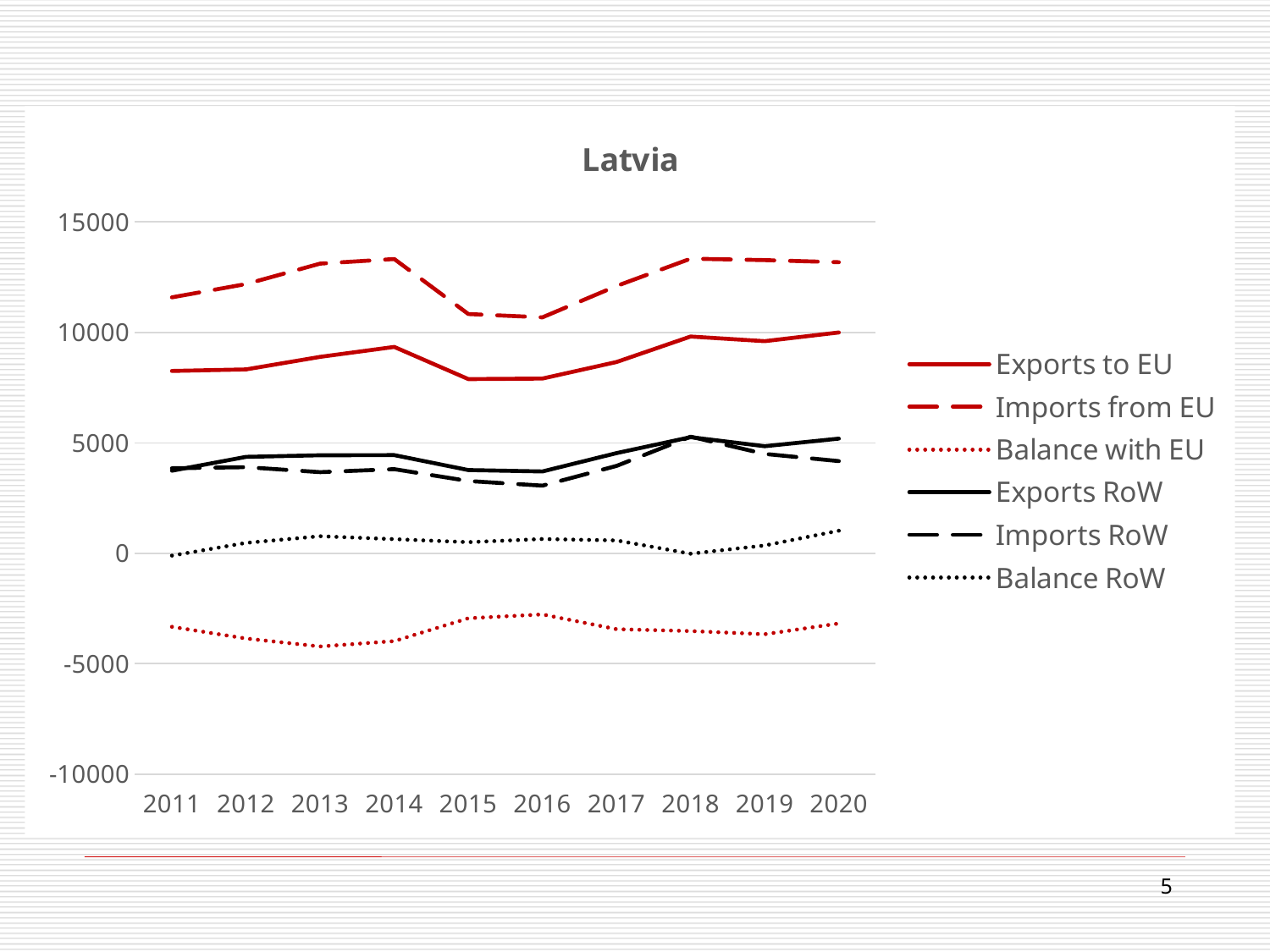
In 2020, which is larger: Exports RoW or Imports RoW? Exports RoW Which series is drawn as a red dotted line? Balance with EU How many years are shown on the x axis? 10 Is the value for Balance with EU in 2013 greater or less than 0? less Is the value for Imports from EU in 2014 greater or less than 10000? greater How many series does the legend list? 6 What kind of chart is shown on the slide? line chart Is the value for Exports to EU in 2015 greater or less than 10000? less Does the Imports from EU line rise or fall from 2014 to 2016? fall What is the title of the chart? Latvia In 2014, which is larger: Imports from EU or Exports to EU? Imports from EU